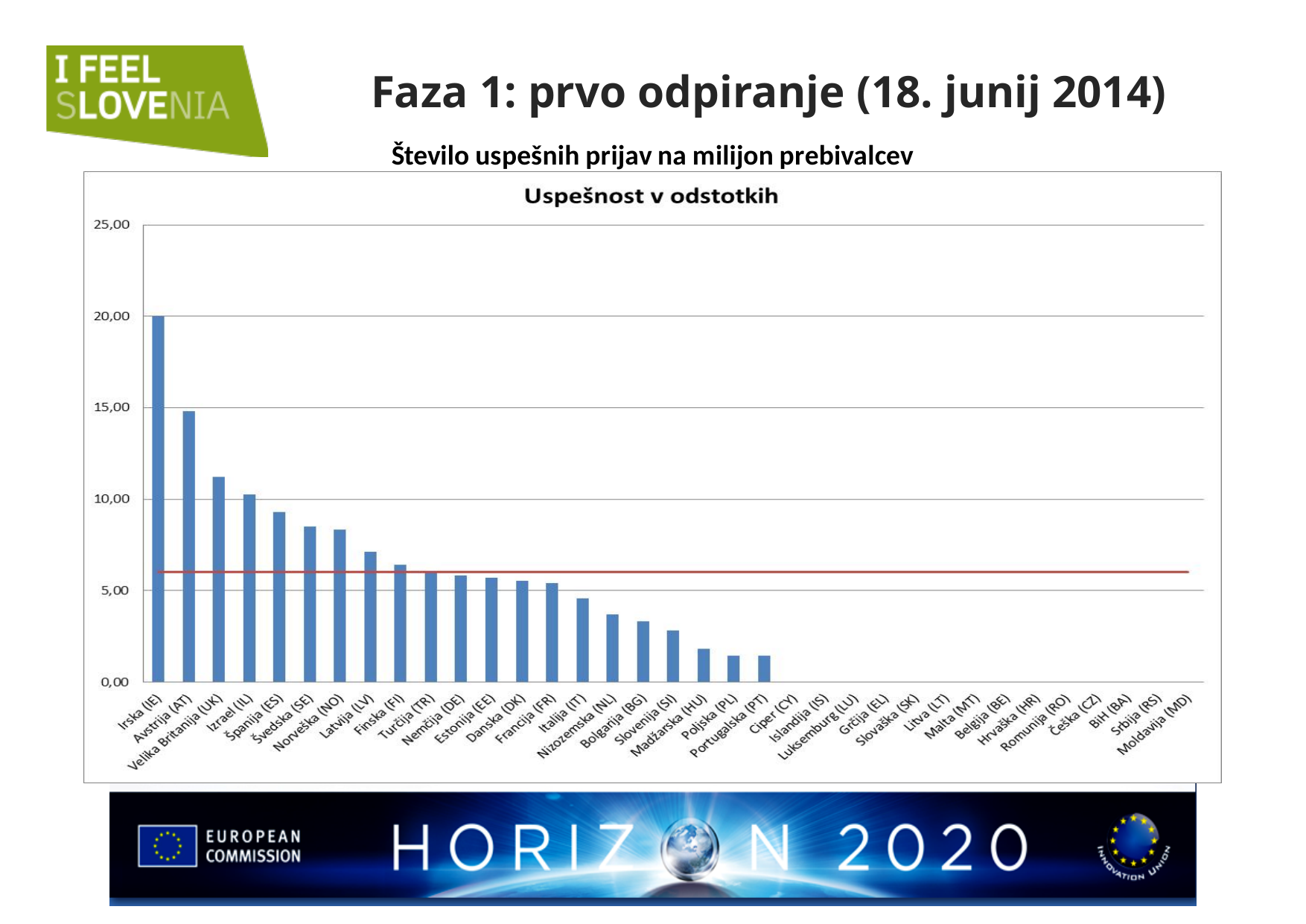
Which has the larger value, Slovenija (SI) or Madžarska (HU)? Slovenija (SI) Do the bar values rise or fall from left to right along the x axis? Fall Is the value for Irska (IE) greater or less than 15,00? greater Which has the larger value, Irska (IE) or Avstrija (AT)? Irska (IE) Is the value for Slovenija (SI) greater or less than 5,00? less What is the title of the chart? Uspešnost v odstotkih Is the value for Latvija (LV) greater or less than 5,00? greater How many countries are listed on the x axis of the chart? 35 What kind of chart is shown on the slide? Bar chart Which country has the highest value in the chart? Irska (IE)